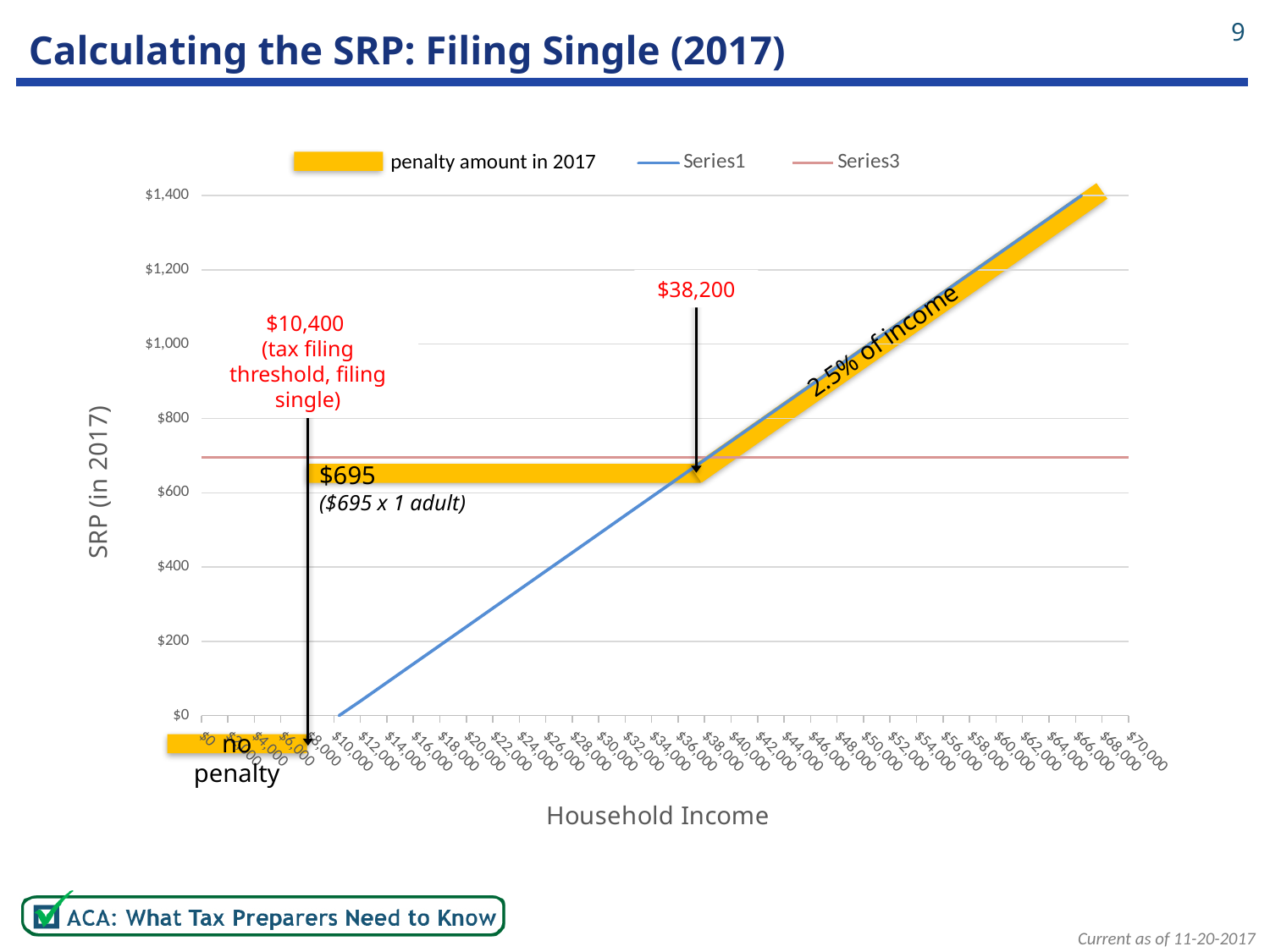
What percentage of income is labeled on the rising part of the penalty line? 2.5% of income What household income is labeled on the chart as the tax filing threshold for filing single? $10,400 How many series does the chart legend list? 3 Is the Series1 value at a household income of $20,000 greater or less than $400? less What is the highest value shown on the y axis of the chart? $1,400 Is the penalty amount in 2017 at a household income of $20,000 greater or less than $600? greater What kind of chart is shown on the slide? line chart What is the title of the x axis of the chart? Household Income Does the penalty amount in 2017 rise or fall as household income increases beyond $38,200? rise At what household income does the chart mark the point where the penalty switches from the flat amount to the percentage of income? $38,200 What flat penalty amount is labeled on the chart for a single adult? $695 What is the title of the y axis of the chart? SRP (in 2017)